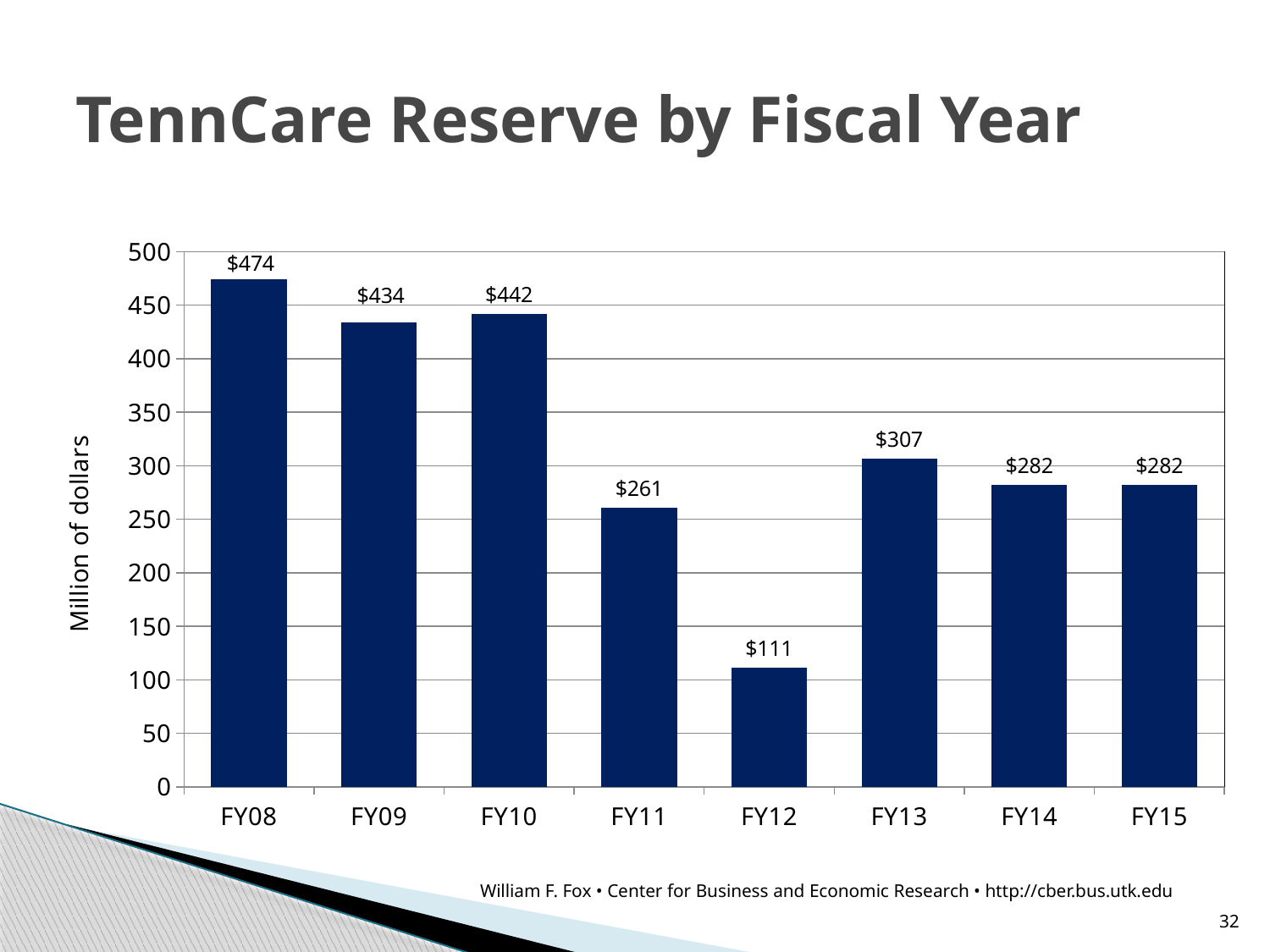
What kind of chart is shown on the slide? bar chart What is the label on the vertical axis of the chart? Million of dollars Which is larger, the TennCare reserve in FY09 or FY10? FY10 How many fiscal years are shown on the chart? 8 Which fiscal year has the lowest TennCare reserve? FY12 Is the TennCare reserve for FY11 greater or less than 300? less What is the difference between the TennCare reserve in FY10 and FY11? $181 What is the TennCare reserve for FY08? $474 What is the difference between the TennCare reserve in FY08 and FY12? $363 What is the TennCare reserve for FY12? $111 Which fiscal year has the highest TennCare reserve? FY08 What is the TennCare reserve for FY13? $307